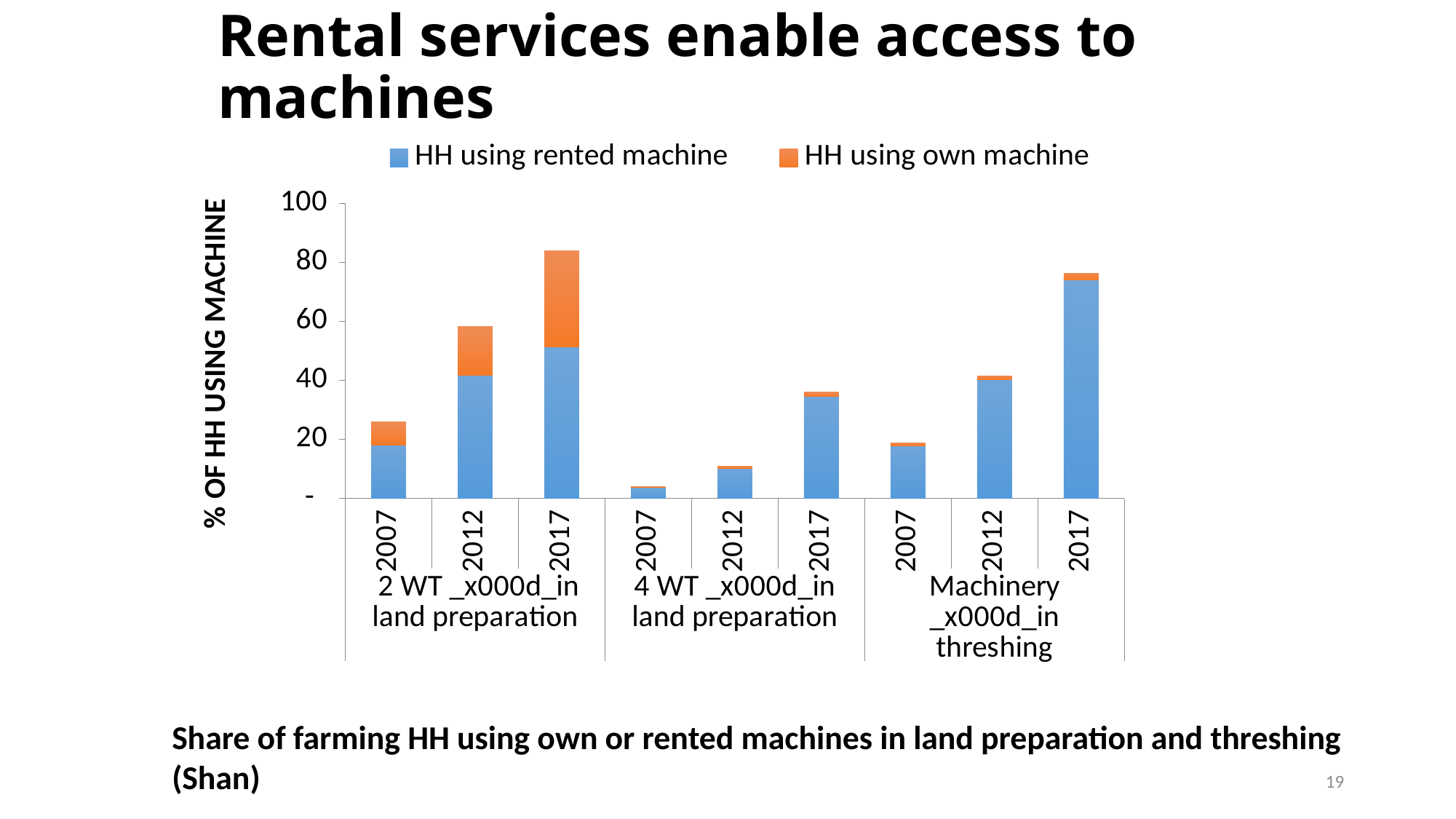
How many series does the legend list? 2 Within each machine group, do the total values rise or fall from 2007 to 2017? Rise Is the total value for Machinery in threshing in 2017 greater or less than 60? greater Which bar has the highest total share of households using a machine? 2 WT in land preparation, 2017 What is the title of the vertical axis? % OF HH USING MACHINE How many bars are plotted in the chart? 9 Is the total value for 2 WT in land preparation in 2012 greater or less than 40? greater Which bar has the lowest total share of households using a machine? 4 WT in land preparation, 2007 Which is larger: the total bar for 2 WT in land preparation in 2007 or for 4 WT in land preparation in 2007? 2 WT in land preparation in 2007 What kind of chart is shown on the slide? Stacked bar chart Is the total value for 2 WT in land preparation in 2017 greater or less than 60? greater